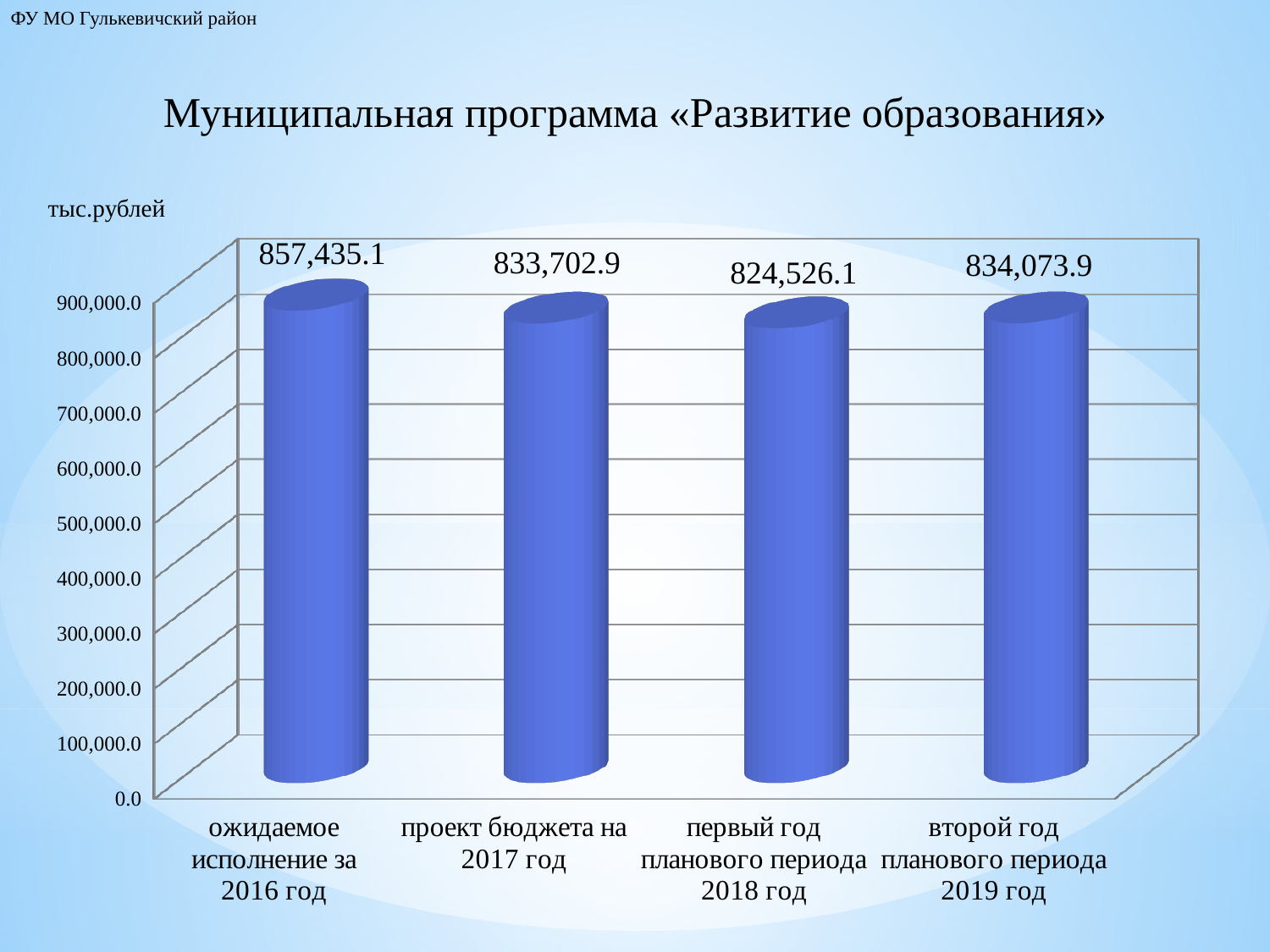
What unit is indicated above the chart's vertical axis? тыс.рублей What is the value for ожидаемое исполнение за 2016 год? 857,435.1 Which is larger: the value for ожидаемое исполнение за 2016 год or the value for первый год планового периода 2018 год? ожидаемое исполнение за 2016 год What kind of chart is shown on the slide? bar chart Which category has the highest value? ожидаемое исполнение за 2016 год Is the value for второй год планового периода 2019 год greater or less than 800,000.0? greater What is the difference between the value for 2016 год and the value for проект бюджета на 2017 год? 23,732.2 Which category has the lowest value? первый год планового периода 2018 год What is the value for первый год планового периода 2018 год? 824,526.1 How many categories are shown on the x axis? 4 What is the value for проект бюджета на 2017 год? 833,702.9 What is the value for второй год планового периода 2019 год? 834,073.9